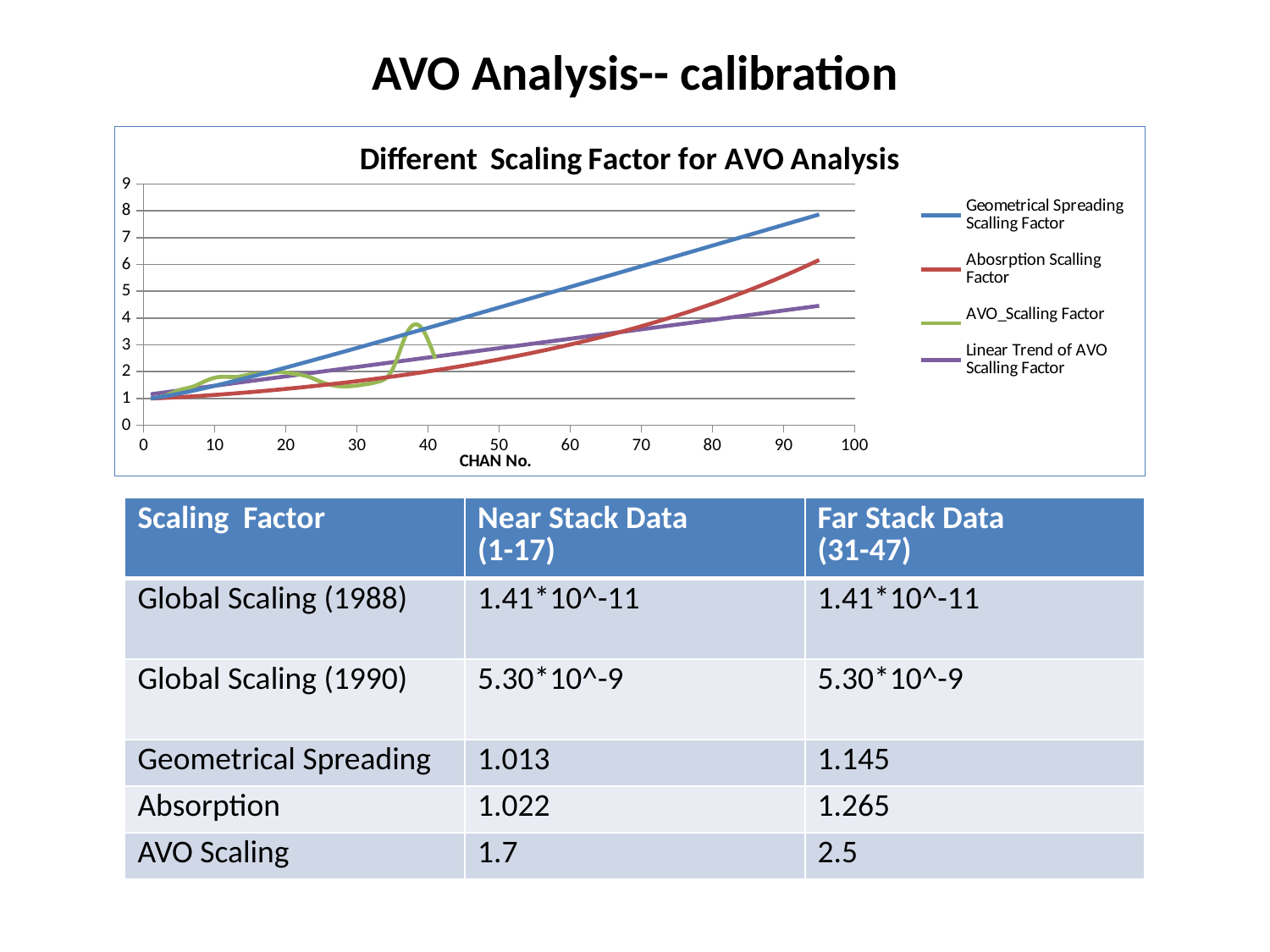
What is the label of the x axis of the chart? CHAN No. Is the value of the Geometrical Spreading Scalling Factor at its right-hand end (around CHAN No. 95) greater or less than 7? greater How many series does the chart legend list? 4 At CHAN No. 20, which is larger: the Abosrption Scalling Factor or the Linear Trend of AVO Scaling Factor? Linear Trend of AVO Scaling Factor What is the title of the chart? Different Scaling Factor for AVO Analysis Is the value of the Abosrption Scalling Factor at its right-hand end (around CHAN No. 95) greater or less than 5? greater Does the Geometrical Spreading Scalling Factor rise or fall as CHAN No. increases? rise What kind of chart is shown on the slide? line chart At CHAN No. 90, which is larger: the Geometrical Spreading Scalling Factor or the Abosrption Scalling Factor? Geometrical Spreading Scalling Factor Which series reaches the highest value on the chart? Geometrical Spreading Scalling Factor Is the value of the Linear Trend of AVO Scaling Factor at its right-hand end (around CHAN No. 95) greater or less than 5? less